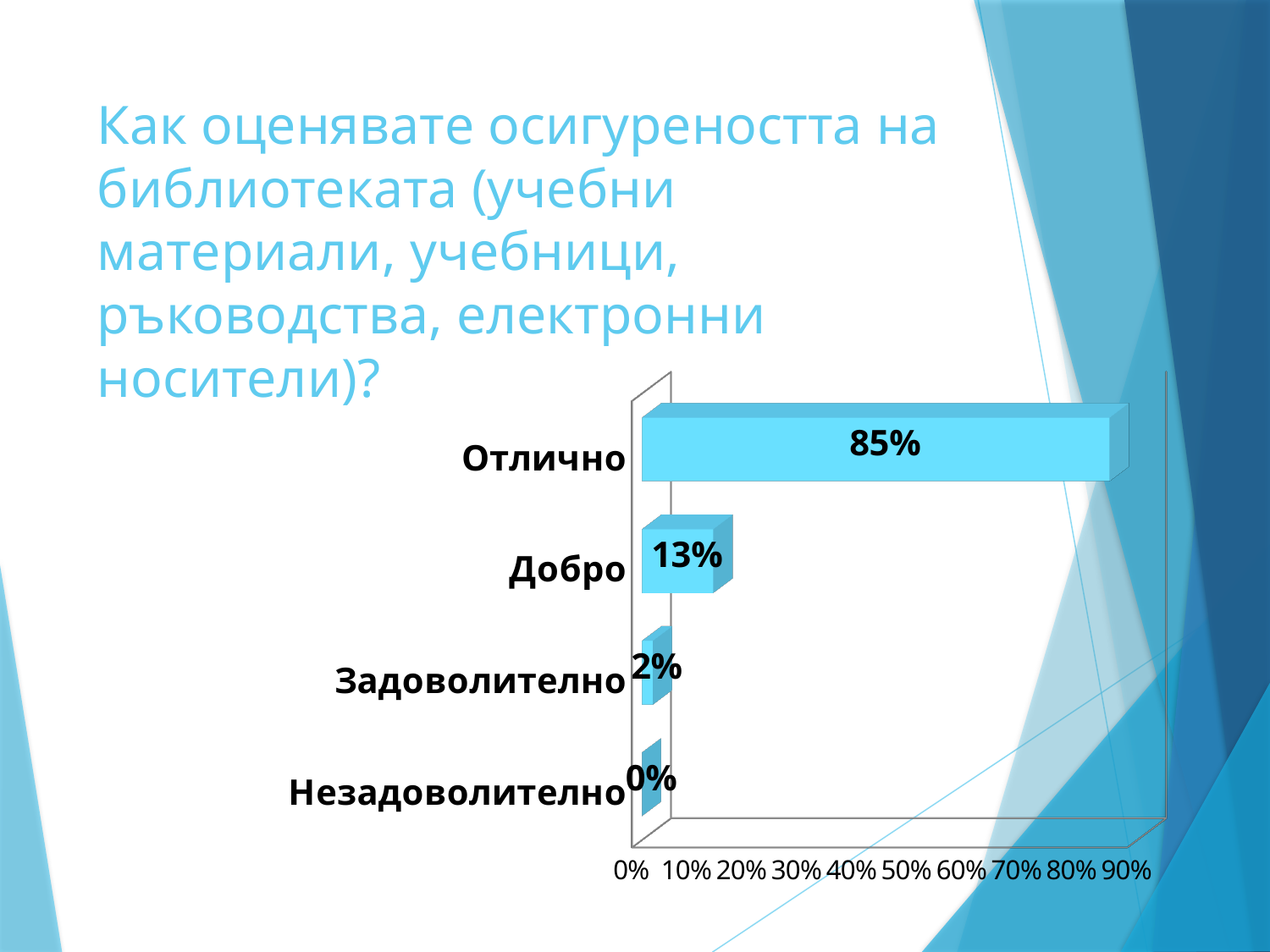
Is the value for Отлично greater or less than 80%? greater What is the value for Отлично? 85% How many categories are shown in the chart? 4 What is the difference between the values for Отлично and Добро? 72% What is the value for Задоволително? 2% What is the value for Добро? 13% What is the highest value shown on the horizontal axis? 90% Which is larger, the value for Добро or the value for Задоволително? Добро What kind of chart is shown on the slide? bar chart Which category has the lowest value? Незадоволително What is the value for Незадоволително? 0% Which category has the highest value? Отлично